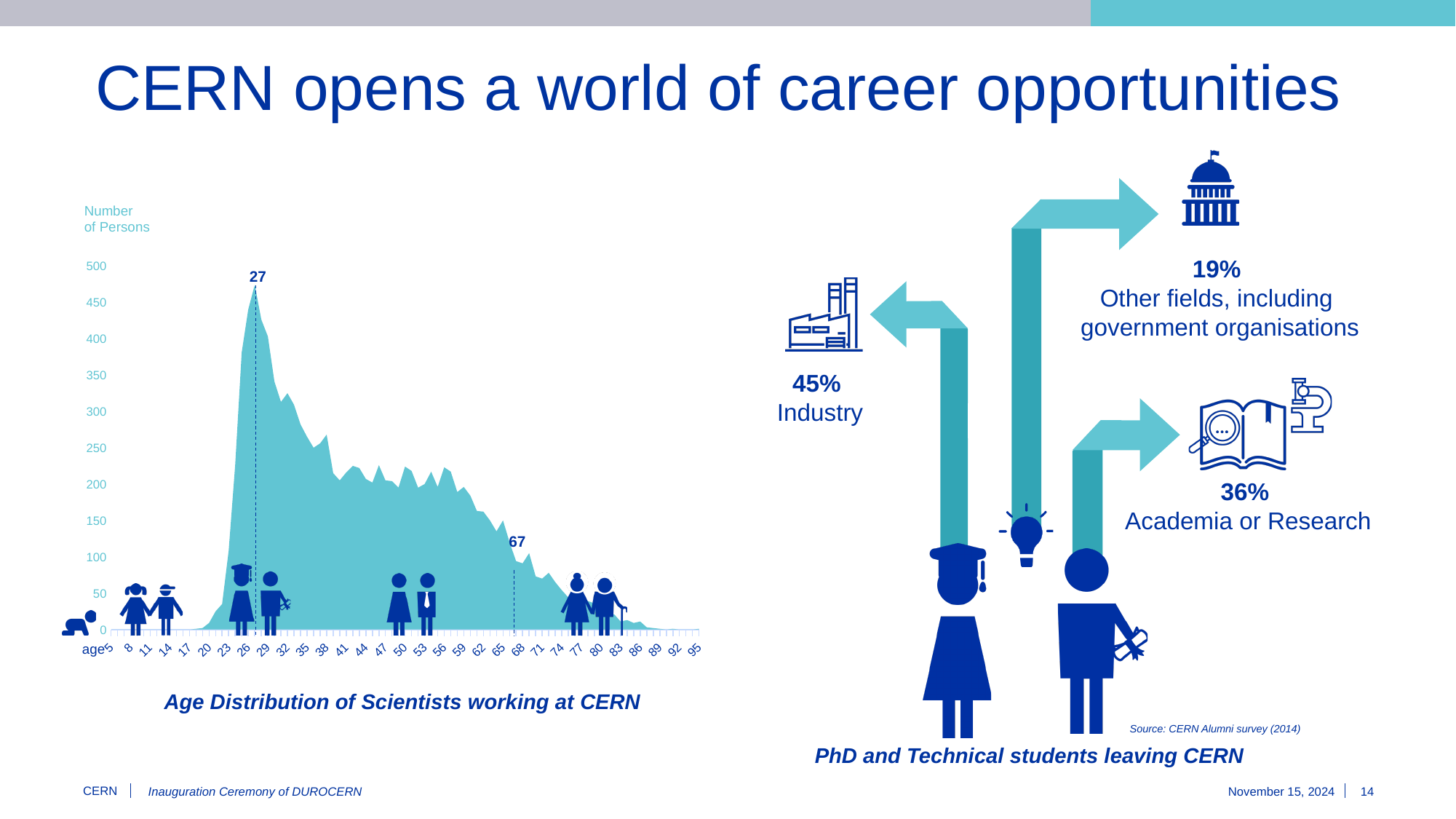
What kind of chart is the 'Age Distribution of Scientists working at CERN' chart? area chart In the 'PhD and Technical students leaving CERN' diagram, what percentage go to Industry? 45% In the 'Age Distribution of Scientists working at CERN' chart, at what age does the distribution reach its peak, as annotated on the chart? 27 In the 'Age Distribution of Scientists working at CERN' chart, what is the second age annotated with a dashed line, besides 27? 67 In the 'PhD and Technical students leaving CERN' diagram, which destination has the lowest percentage? Other fields, including government organisations In the 'PhD and Technical students leaving CERN' diagram, what is the difference in percentage points between Industry and Academia or Research? 9 In the 'Age Distribution of Scientists working at CERN' chart, is the number of persons at age 27 greater or less than 400? greater In the 'Age Distribution of Scientists working at CERN' chart, do the values generally rise or fall from age 27 to age 95? fall In the 'Age Distribution of Scientists working at CERN' chart, what is the label of the vertical axis? Number of Persons In the 'Age Distribution of Scientists working at CERN' chart, is the number of persons at age 80 greater or less than 100? less In the 'Age Distribution of Scientists working at CERN' chart, is the number of persons at age 50 greater or less than 300? less In the 'Age Distribution of Scientists working at CERN' chart, what is the highest tick value shown on the vertical axis? 500